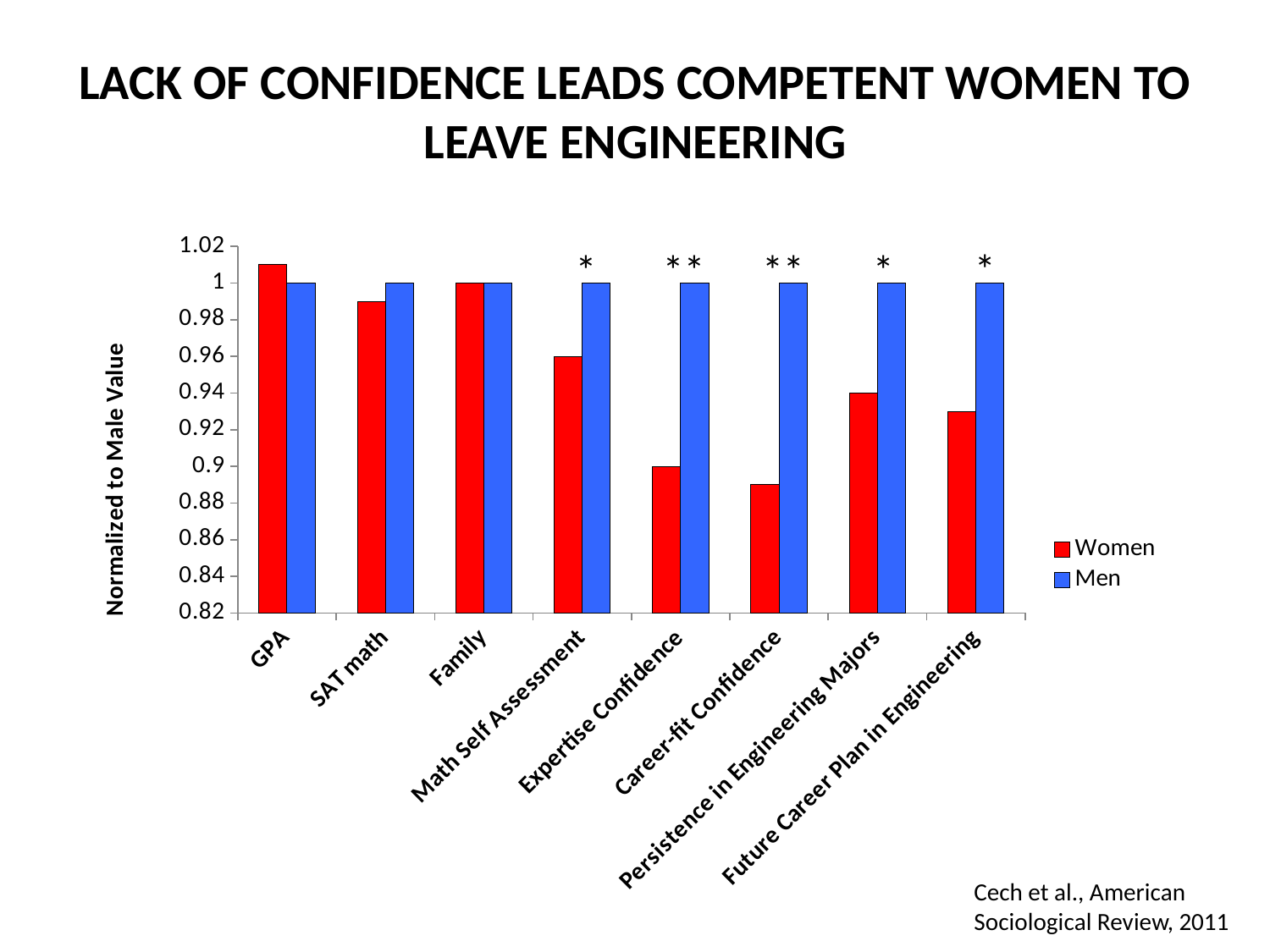
Is the value for Women in Career-fit Confidence greater or less than 0.92? less Which is larger, the Women value for Math Self Assessment or the Women value for Persistence in Engineering Majors? Math Self Assessment What is the title of the y axis? Normalized to Male Value What is the value for Women in the Math Self Assessment category? 0.96 What is the value for Women in the Expertise Confidence category? 0.9 What kind of chart is shown on the slide? bar chart What is the value for Women in the Family category? 1 Is the value for Women in SAT math greater or less than 0.96? greater How many categories are shown on the x axis? 8 What is the difference between the Women value for Math Self Assessment and the Women value for Expertise Confidence? 0.06 What is the value for Men in the GPA category? 1 How many series does the legend list? 2